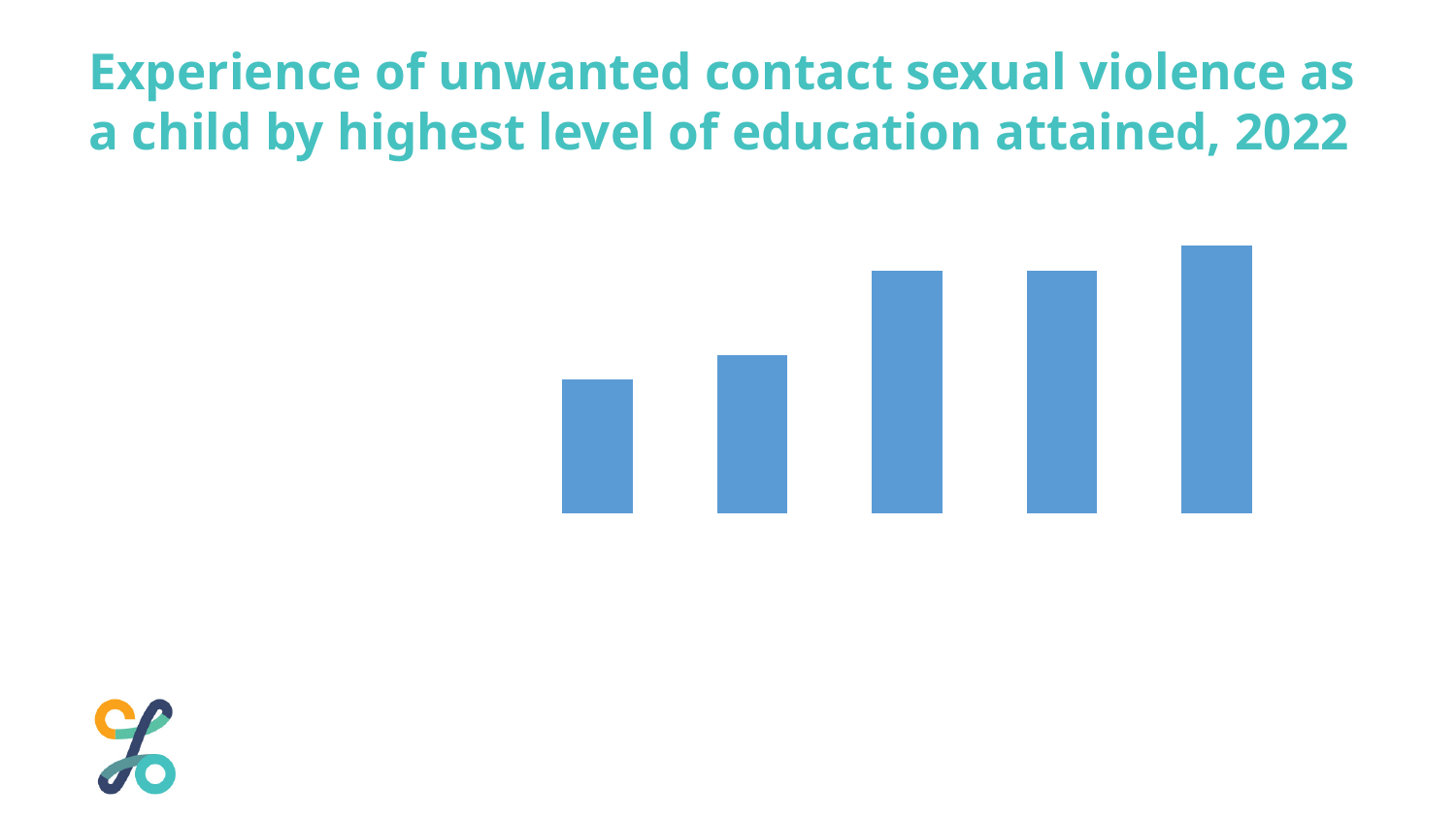
What colour are the bars in the chart? blue Which bar is the shortest in the chart, by position from the left? the first (leftmost) bar What is the title of the chart on the slide? Experience of unwanted contact sexual violence as a child by highest level of education attained, 2022 Which bar is the tallest in the chart, by position from the left? the fifth (rightmost) bar Which is taller, the first bar from the left or the second bar from the left? the second bar Which is taller, the second bar from the left or the fourth bar from the left? the fourth bar What kind of chart is shown on the slide? bar chart How many bars are plotted in the chart? 5 Which is taller, the third bar from the left or the fifth bar from the left? the fifth bar Do the bar heights generally rise or fall from left to right across the chart? rise